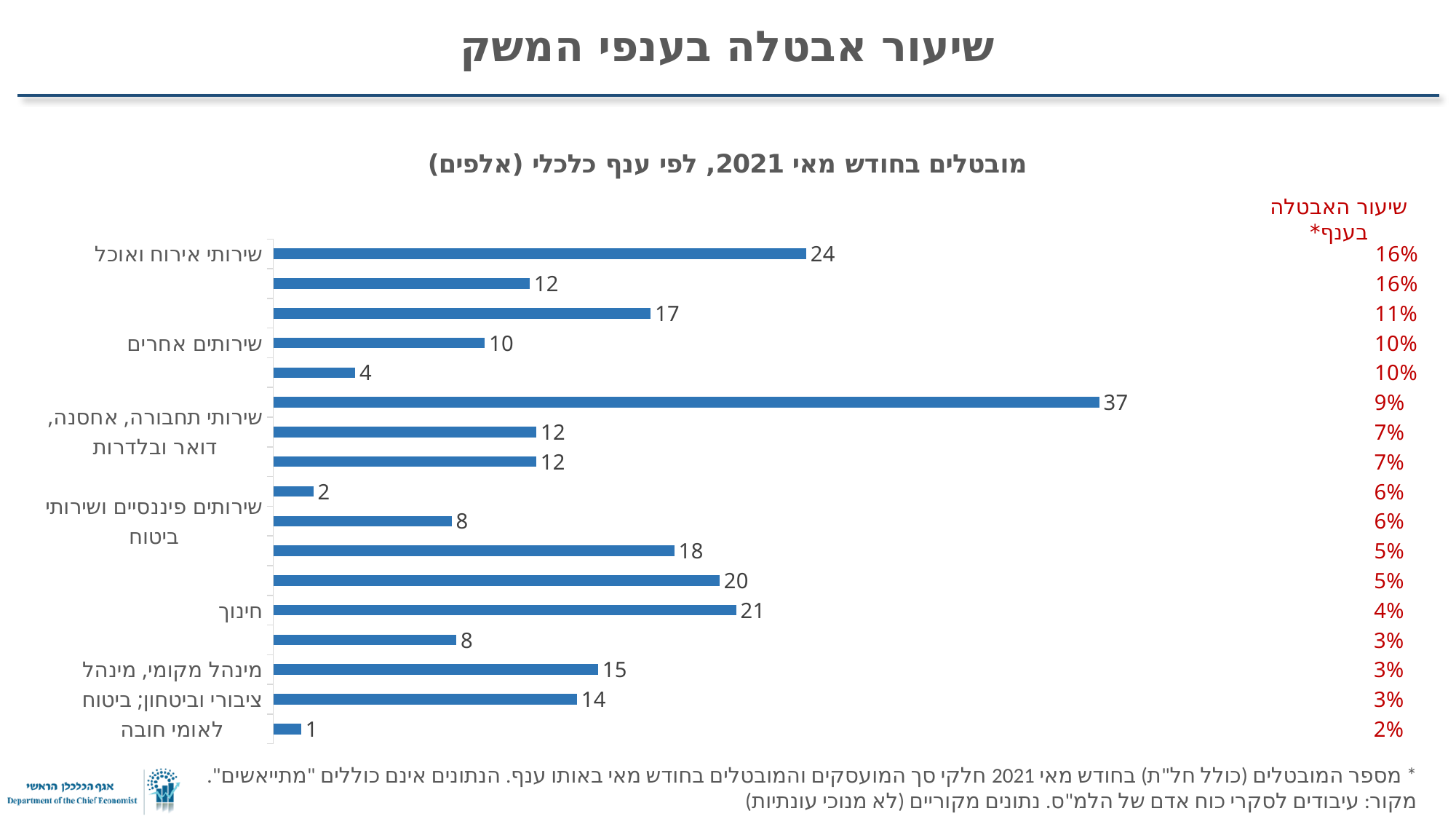
How many bars are plotted in the chart? 17 What unemployment rate (שיעור האבטלה בענף) is listed in red next to the bar for שירותי אירוח ואוכל? 16% What is the difference between the value for שירותי אירוח ואוכל and the value for שירותים אחרים? 14 What is the lowest value shown on any bar in the chart? 1 Which has a larger value, חינוך or שירותי אירוח ואוכל? שירותי אירוח ואוכל What is the value of the bar for שירותים אחרים? 10 What is the highest value shown on any bar in the chart? 37 What colour are the bars in the chart? blue What is the value of the bar for חינוך? 21 What is the title of the chart? מובטלים בחודש מאי 2021, לפי ענף כלכלי (אלפים) What is the value of the bar for שירותי אירוח ואוכל? 24 What kind of chart is shown on the slide? bar chart